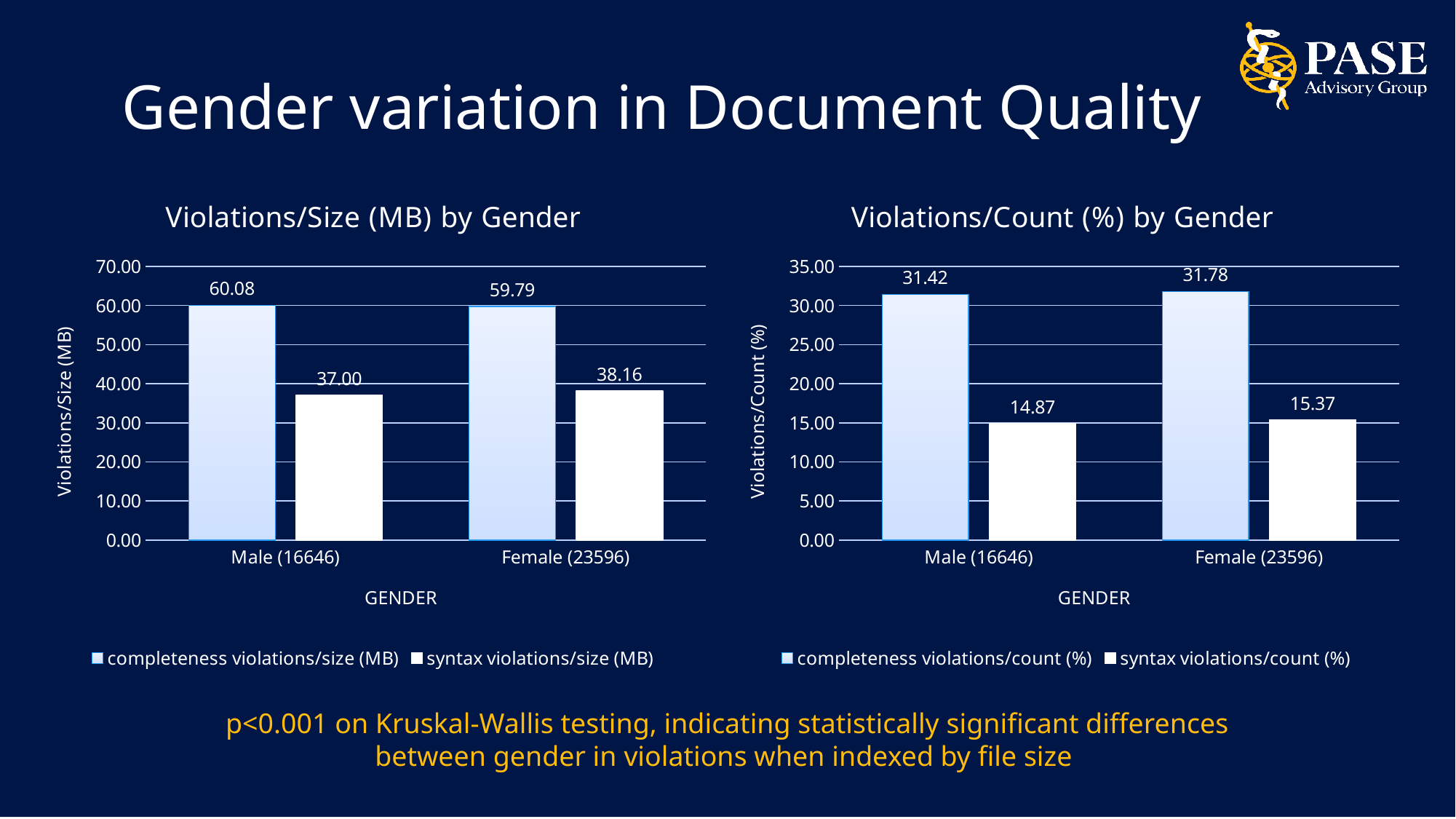
In the 'Violations/Count (%) by Gender' chart, what is the value of syntax violations/count (%) for Male (16646)? 14.87 In the 'Violations/Count (%) by Gender' chart, what is the difference in syntax violations/count (%) between Female (23596) and Male (16646)? 0.50 In the 'Violations/Count (%) by Gender' chart, which bar is the lowest? syntax violations/count (%) for Male (16646) In the 'Violations/Count (%) by Gender' chart, what is the value of completeness violations/count (%) for Female (23596)? 31.78 In the 'Violations/Size (MB) by Gender' chart, what is the difference between completeness violations/size (MB) and syntax violations/size (MB) for Male (16646)? 23.08 How many series does the legend of the 'Violations/Count (%) by Gender' chart list? 2 In the 'Violations/Size (MB) by Gender' chart, what is the value of completeness violations/size (MB) for Male (16646)? 60.08 In the 'Violations/Size (MB) by Gender' chart, which gender has the higher syntax violations/size (MB)? Female (23596) What type of chart is the 'Violations/Count (%) by Gender' chart? Bar chart In the 'Violations/Size (MB) by Gender' chart, which bar is the highest? completeness violations/size (MB) for Male (16646) In the 'Violations/Size (MB) by Gender' chart, what is the value of syntax violations/size (MB) for Female (23596)? 38.16 How many gender categories are shown on the x axis of the 'Violations/Size (MB) by Gender' chart? 2